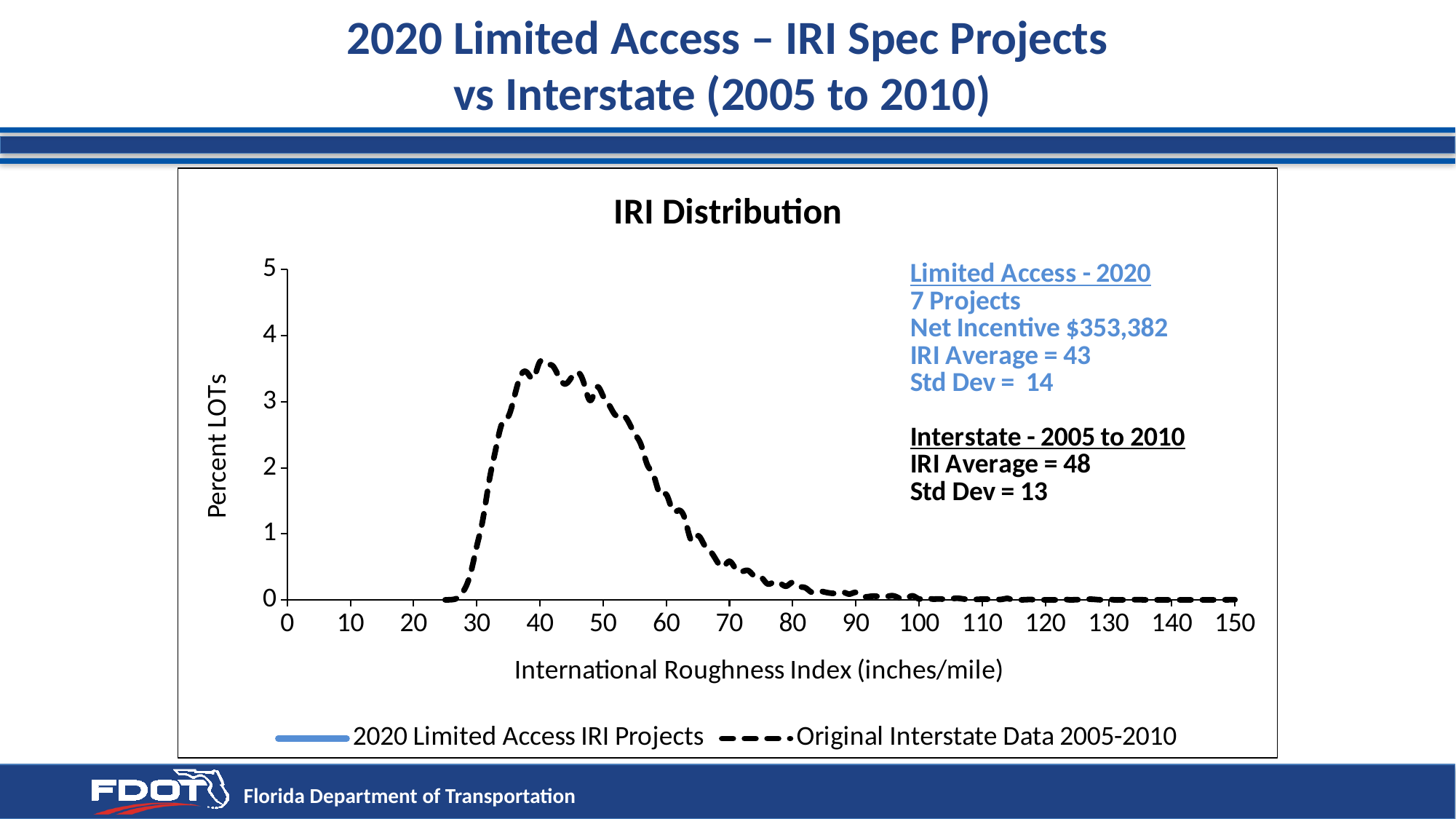
What is the title of the chart? IRI Distribution Is the value of the Original Interstate Data 2005-2010 line at an IRI of 80 greater or less than 1? less According to the text on the chart, what is the IRI Average for Limited Access - 2020? 43 How many series does the chart legend list? 2 Is the value of the Original Interstate Data 2005-2010 line at an IRI of 40 greater or less than 3? greater Does the Original Interstate Data 2005-2010 line rise or fall as the IRI increases from 50 to 100? fall What is the label of the y axis of the chart? Percent LOTs According to the text on the chart, what is the IRI Average for Interstate - 2005 to 2010? 48 For the Original Interstate Data 2005-2010 line, is the value at an IRI of 40 or at an IRI of 70 larger? 40 What kind of chart is shown on the slide? line chart According to the text on the chart, what is the Std Dev for Interstate - 2005 to 2010? 13 According to the text on the chart, how many projects are in Limited Access - 2020? 7 Projects